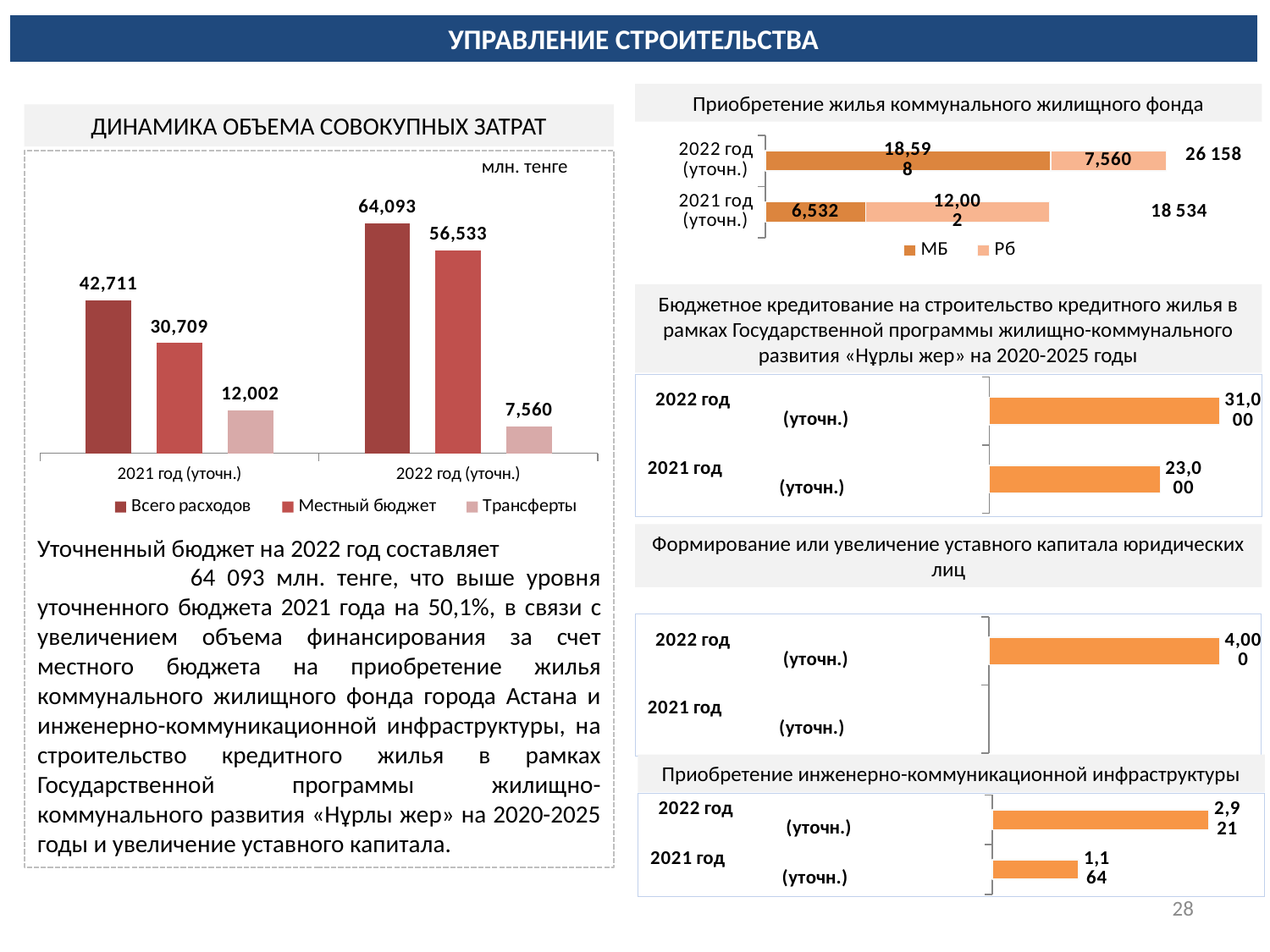
In the chart 'Приобретение инженерно-коммуникационной инфраструктуры', what is the value for 2022 год (уточн.)? 2,921 In the chart 'Бюджетное кредитование на строительство кредитного жилья...', what is the value for 2021 год (уточн.)? 23,000 In the chart 'ДИНАМИКА ОБЪЕМА СОВОКУПНЫХ ЗАТРАТ', what is the value of 'Всего расходов' for 2022 год (уточн.)? 64,093 In the chart 'ДИНАМИКА ОБЪЕМА СОВОКУПНЫХ ЗАТРАТ', what is the value of 'Трансферты' for 2021 год (уточн.)? 12,002 In the chart 'Приобретение жилья коммунального жилищного фонда', what is the total of the stacked bar for 2021 год (уточн.)? 18 534 In the chart 'ДИНАМИКА ОБЪЕМА СОВОКУПНЫХ ЗАТРАТ', how many series does the legend list? 3 In the chart 'ДИНАМИКА ОБЪЕМА СОВОКУПНЫХ ЗАТРАТ', what unit is shown in the top-right corner of the plot area? млн. тенге In the chart 'Приобретение жилья коммунального жилищного фонда', which is larger for 2021 год (уточн.): МБ or РБ? РБ What kind of chart is 'Формирование или увеличение уставного капитала юридических лиц'? bar chart In the chart 'ДИНАМИКА ОБЪЕМА СОВОКУПНЫХ ЗАТРАТ', does 'Трансферты' rise or fall from 2021 год (уточн.) to 2022 год (уточн.)? fall In the chart 'ДИНАМИКА ОБЪЕМА СОВОКУПНЫХ ЗАТРАТ', what is the difference between 'Местный бюджет' in 2022 год (уточн.) and in 2021 год (уточн.)? 25,824 In the chart 'Приобретение жилья коммунального жилищного фонда', what is the value of МБ for 2022 год (уточн.)? 18,598